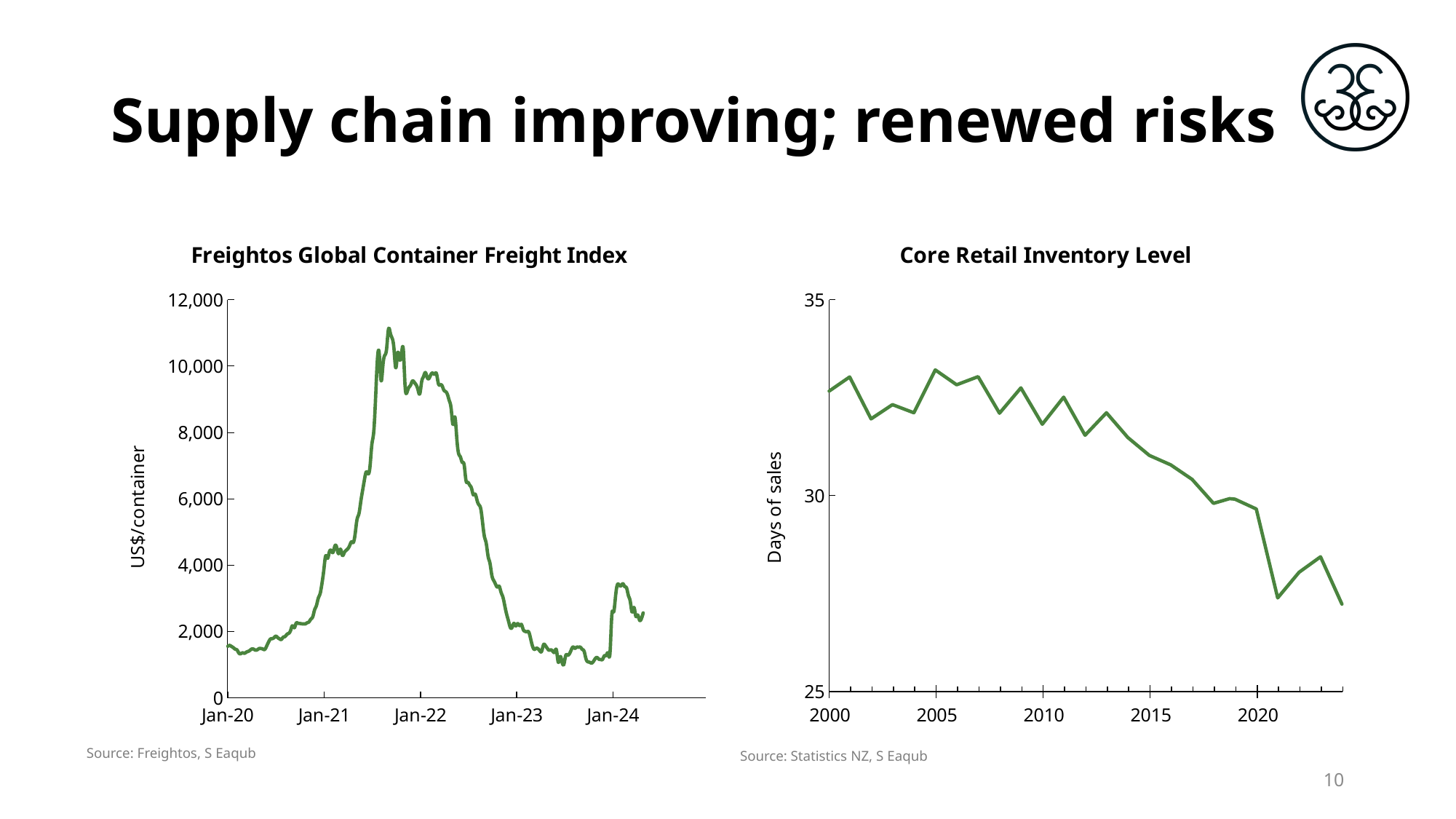
On the Core Retail Inventory Level chart, is the value in 2015 greater or less than 30? greater What is the y-axis label on the Freightos Global Container Freight Index chart? US$/container What is the y-axis label on the Core Retail Inventory Level chart? Days of sales On the Freightos Global Container Freight Index chart, is the value at Jan-22 greater or less than 8,000? greater On the Core Retail Inventory Level chart, do values generally rise or fall from 2000 to the end of the series? fall What kind of chart is the Core Retail Inventory Level chart? line chart On the Freightos Global Container Freight Index chart, is the value at Jan-23 greater or less than 4,000? less What kind of chart is the Freightos Global Container Freight Index chart? line chart On the Freightos Global Container Freight Index chart, which is larger, the value at Jan-22 or the value at Jan-23? Jan-22 On the Core Retail Inventory Level chart, which is larger, the value in 2005 or the value in 2020? 2005